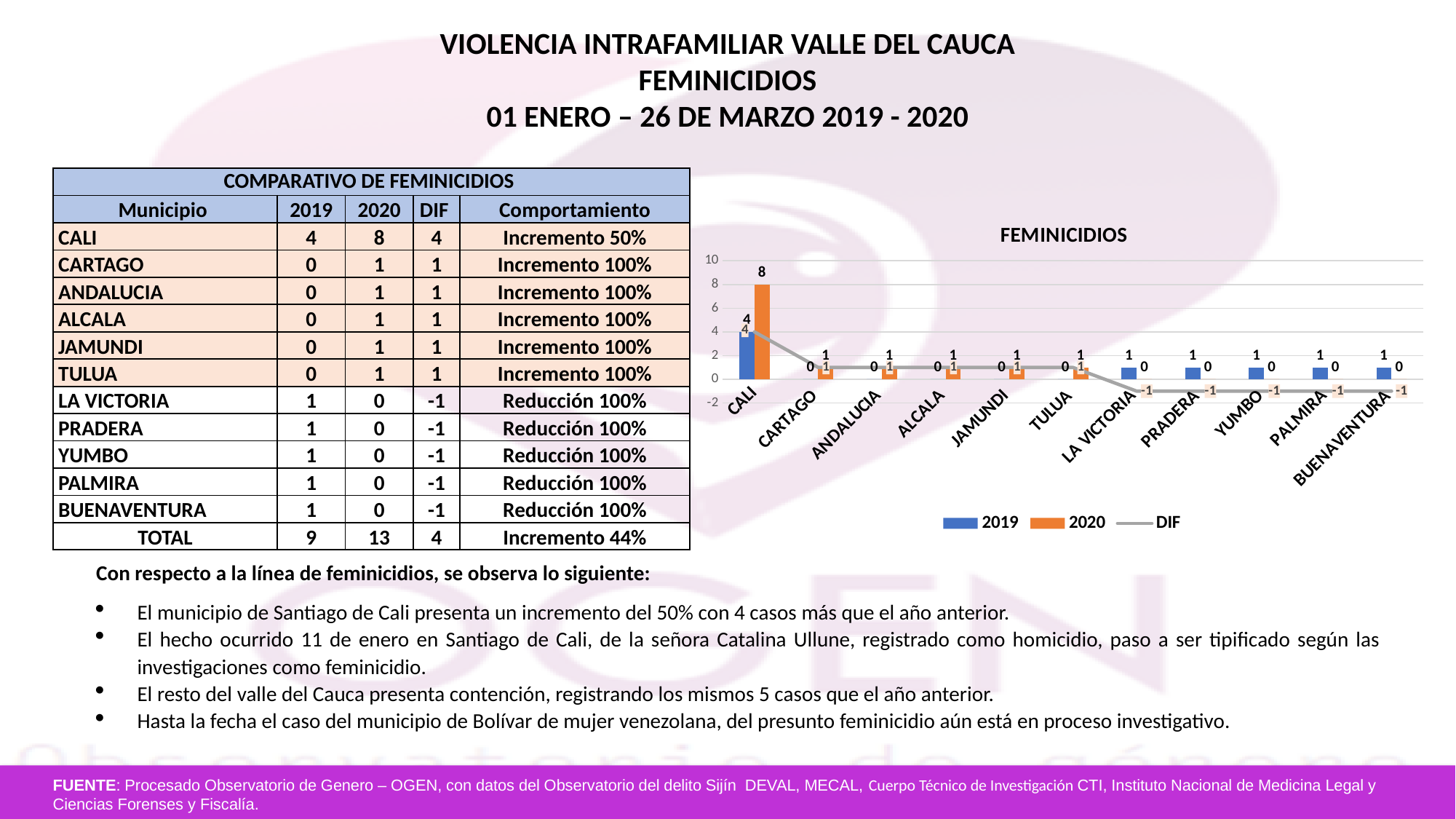
What is the DIF value for LA VICTORIA in the FEMINICIDIOS chart? -1 What kind of chart is the FEMINICIDIOS chart? Combined bar and line chart What is the 2019 value for CALI in the FEMINICIDIOS chart? 4 Which municipality has the highest 2020 value in the FEMINICIDIOS chart? CALI In the FEMINICIDIOS chart, is the 2019 value for PALMIRA larger or the 2020 value for PALMIRA? 2019 Which series in the FEMINICIDIOS chart is drawn as a line? DIF What is the 2020 value for CALI in the FEMINICIDIOS chart? 8 What is the difference between the 2020 and 2019 values for CALI in the FEMINICIDIOS chart? 4 How many series does the legend of the FEMINICIDIOS chart list? 3 How many municipalities are shown on the x axis of the FEMINICIDIOS chart? 11 Is the 2020 value for CALI in the FEMINICIDIOS chart greater or less than 6? greater What is the 2020 value for CARTAGO in the FEMINICIDIOS chart? 1